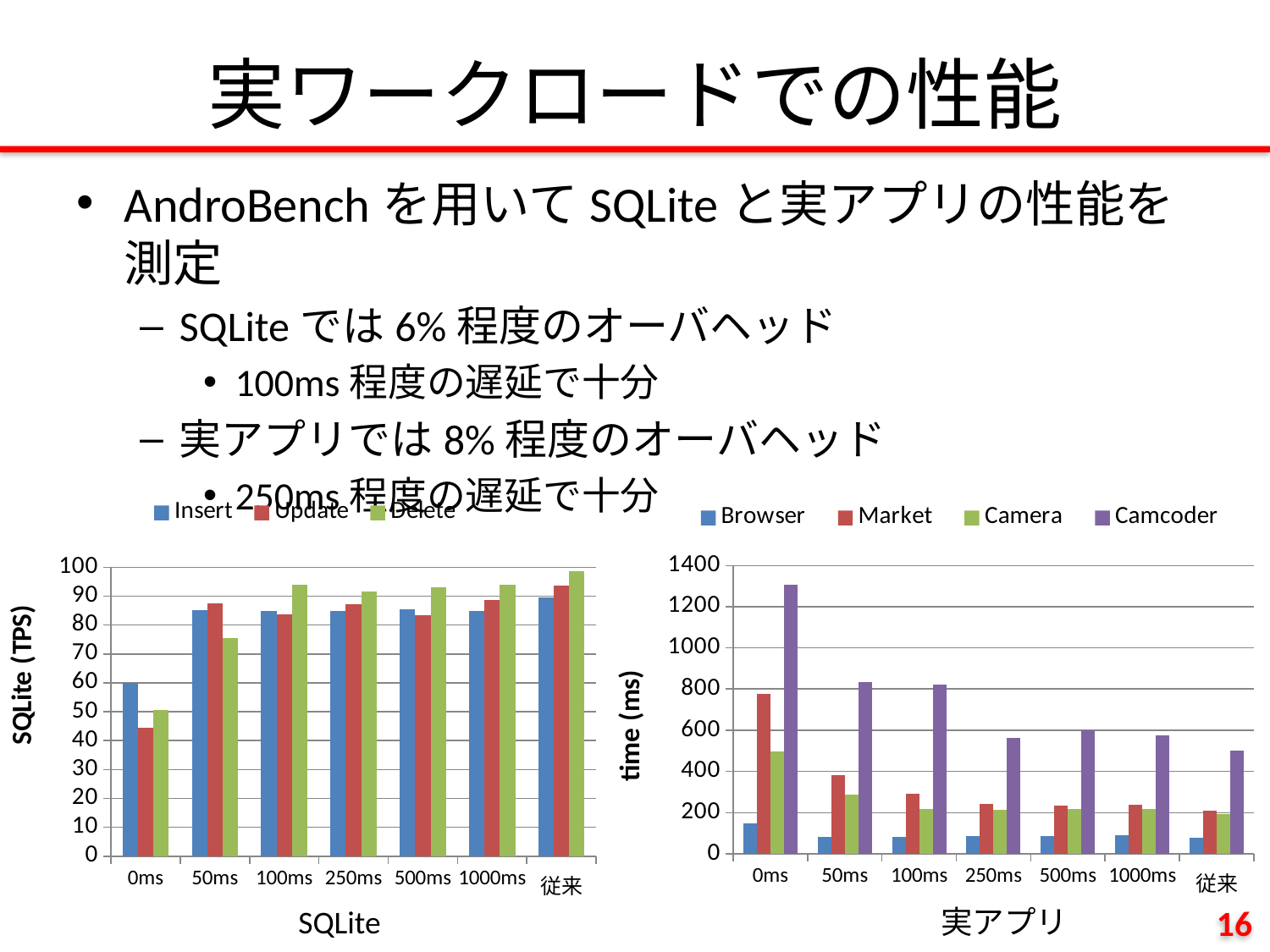
In the SQLite chart on the left, how many series does the legend list? 3 In the SQLite chart on the left, what kind of chart is shown? bar chart In the SQLite chart on the left, at 0ms, which is larger: Insert or Update? Insert In the SQLite chart on the left, which category has the lowest Delete value? 0ms In the SQLite chart on the left, is the Update value at 0ms greater or less than 50? less In the 実アプリ chart on the right, at 0ms, which is larger: Market or Camera? Market In the 実アプリ chart on the right, what is the label of the y axis? time (ms) In the 実アプリ chart on the right, how many series does the legend list? 4 In the 実アプリ chart on the right, is the Browser value at 0ms greater or less than 200? less In the 実アプリ chart on the right, which category has the highest Camcoder value? 0ms In the 実アプリ chart on the right, is the Camcoder value at 0ms greater or less than 1200? greater In the SQLite chart on the left, how many categories are shown on the x axis? 7